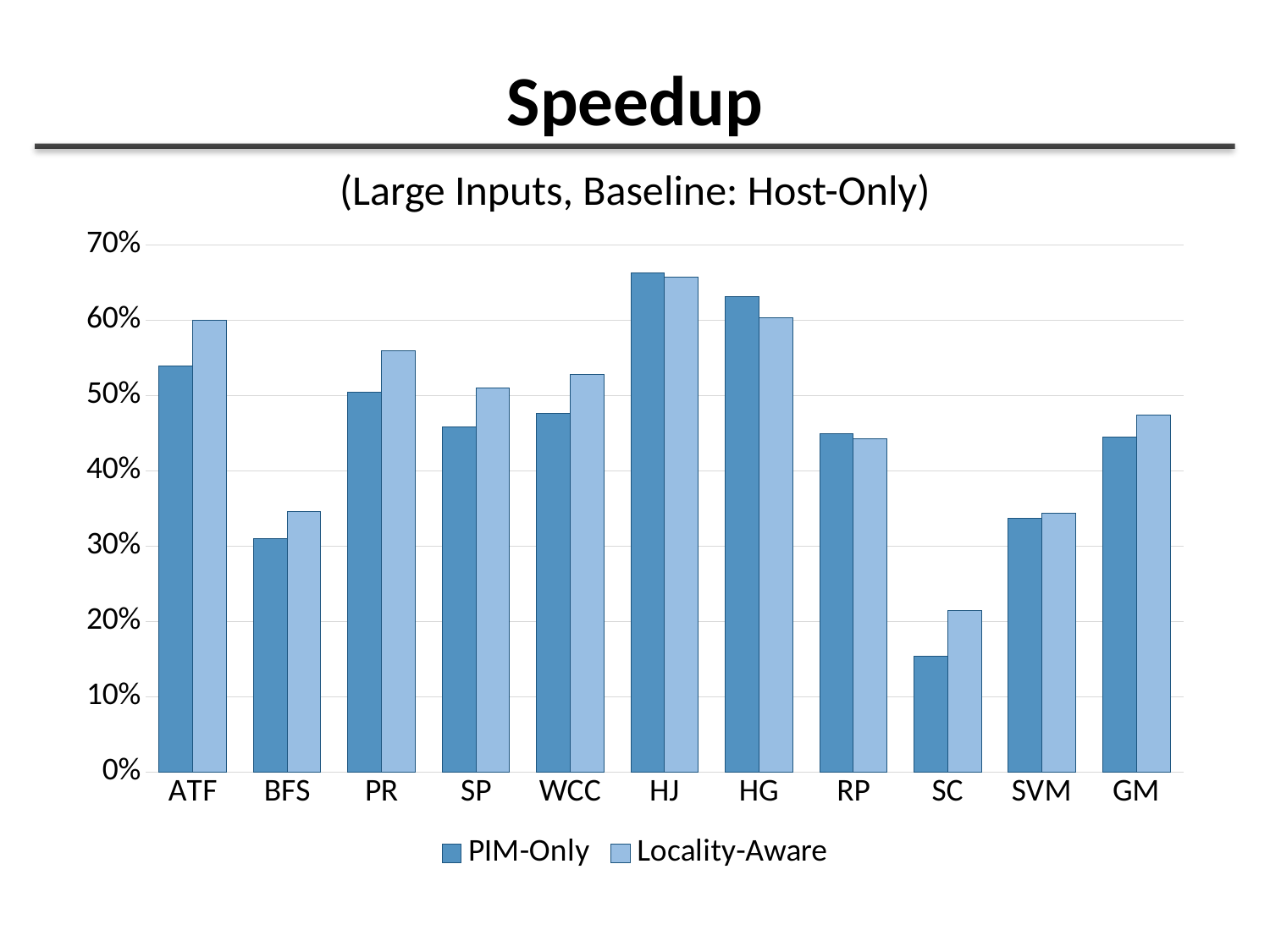
What kind of chart is shown on the slide? bar chart Is the PIM-Only value for ATF greater or less than 50%? greater What subtitle appears above the chart? (Large Inputs, Baseline: Host-Only) For ATF, which series has the larger value, PIM-Only or Locality-Aware? Locality-Aware Which category has the lowest Locality-Aware value? SC Which category has the lowest PIM-Only value? SC How many series does the legend list? 2 Which category has the highest PIM-Only value? HJ For HG, which series has the larger value, PIM-Only or Locality-Aware? PIM-Only Is the PIM-Only value for SC greater or less than 20%? less Is the PIM-Only value for HJ greater or less than 60%? greater How many categories are shown on the x axis? 11